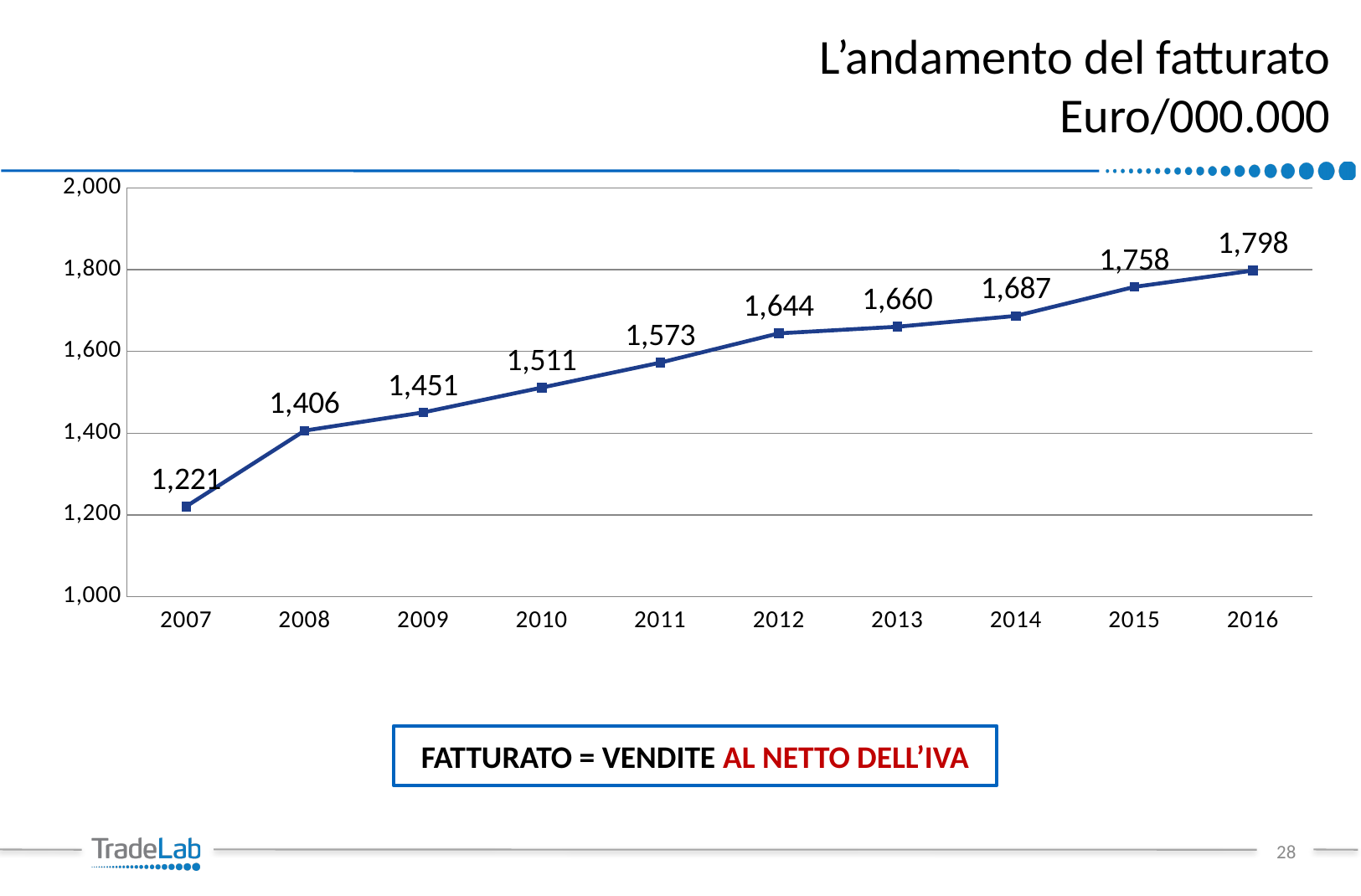
Which is larger, the value for 2013 or the value for 2014? 2014 What is the difference between the values for 2008 and 2007? 185 Which year has the highest value? 2016 What is the value for 2016? 1,798 What is the difference between the values for 2016 and 2007? 577 What kind of chart is shown on the slide? line chart How many years are plotted on the chart? 10 Which year has the lowest value? 2007 Do the values rise or fall from 2007 to 2016? rise Is the value for 2011 greater or less than 1,600? less What is the value for 2012? 1,644 What is the value for 2007? 1,221